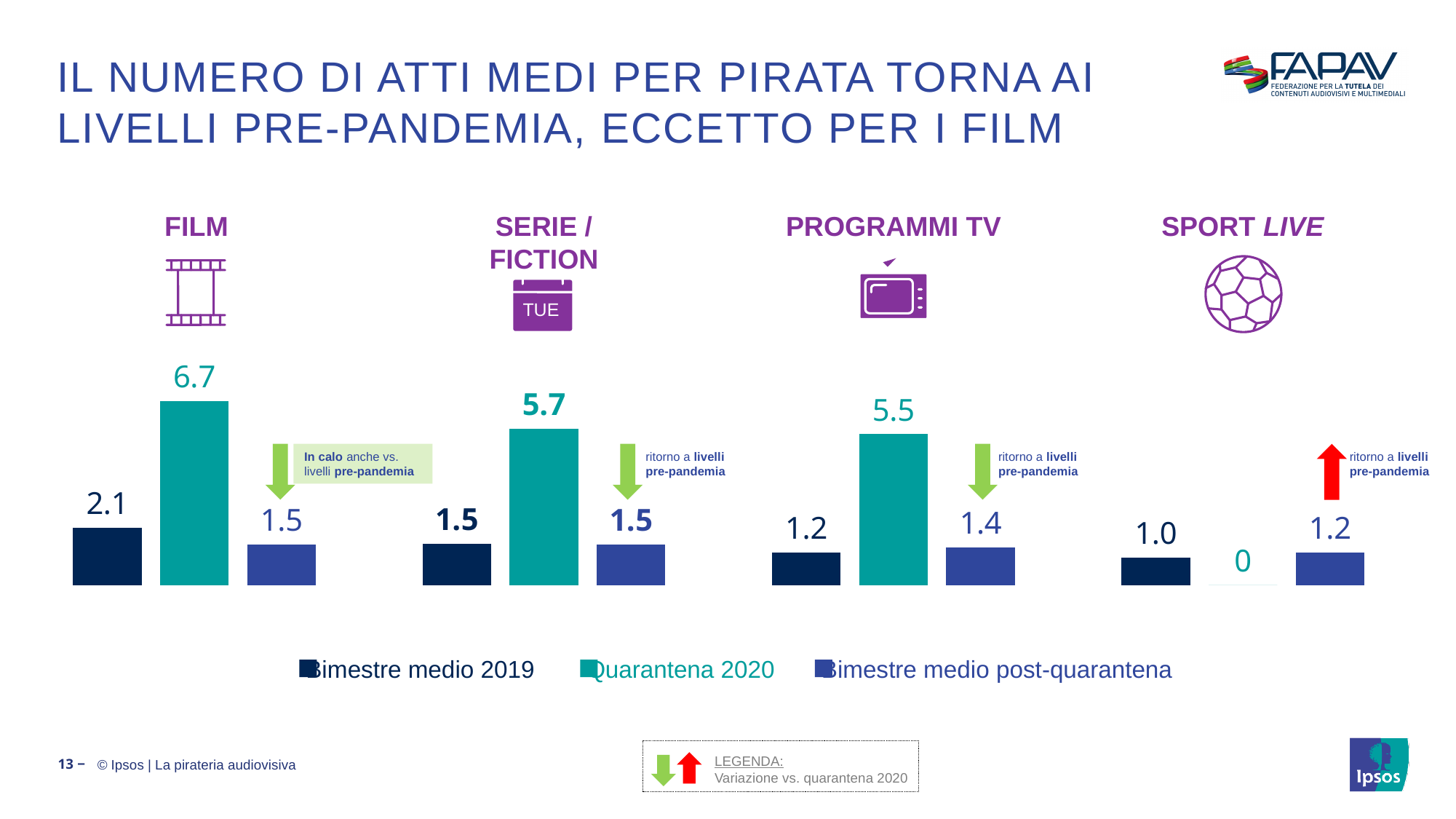
How many content categories are shown in the chart? 4 Which category has the lowest value in the Bimestre medio 2019 series? SPORT LIVE How many series does the legend list? 3 Which series is shown in teal in the legend? Quarantena 2020 What kind of chart is shown on the slide? Bar chart What is the difference between the Quarantena 2020 value and the Bimestre medio post-quarantena value for FILM? 5.2 What is the value for SPORT LIVE in the Quarantena 2020 series? 0 Which category has the highest value in the Quarantena 2020 series? FILM What is the value for SERIE / FICTION in the Bimestre medio 2019 series? 1.5 What is the value for PROGRAMMI TV in the Bimestre medio post-quarantena series? 1.4 For PROGRAMMI TV, which is larger: the Bimestre medio 2019 value or the Bimestre medio post-quarantena value? Bimestre medio post-quarantena What is the value for FILM in the Quarantena 2020 series? 6.7